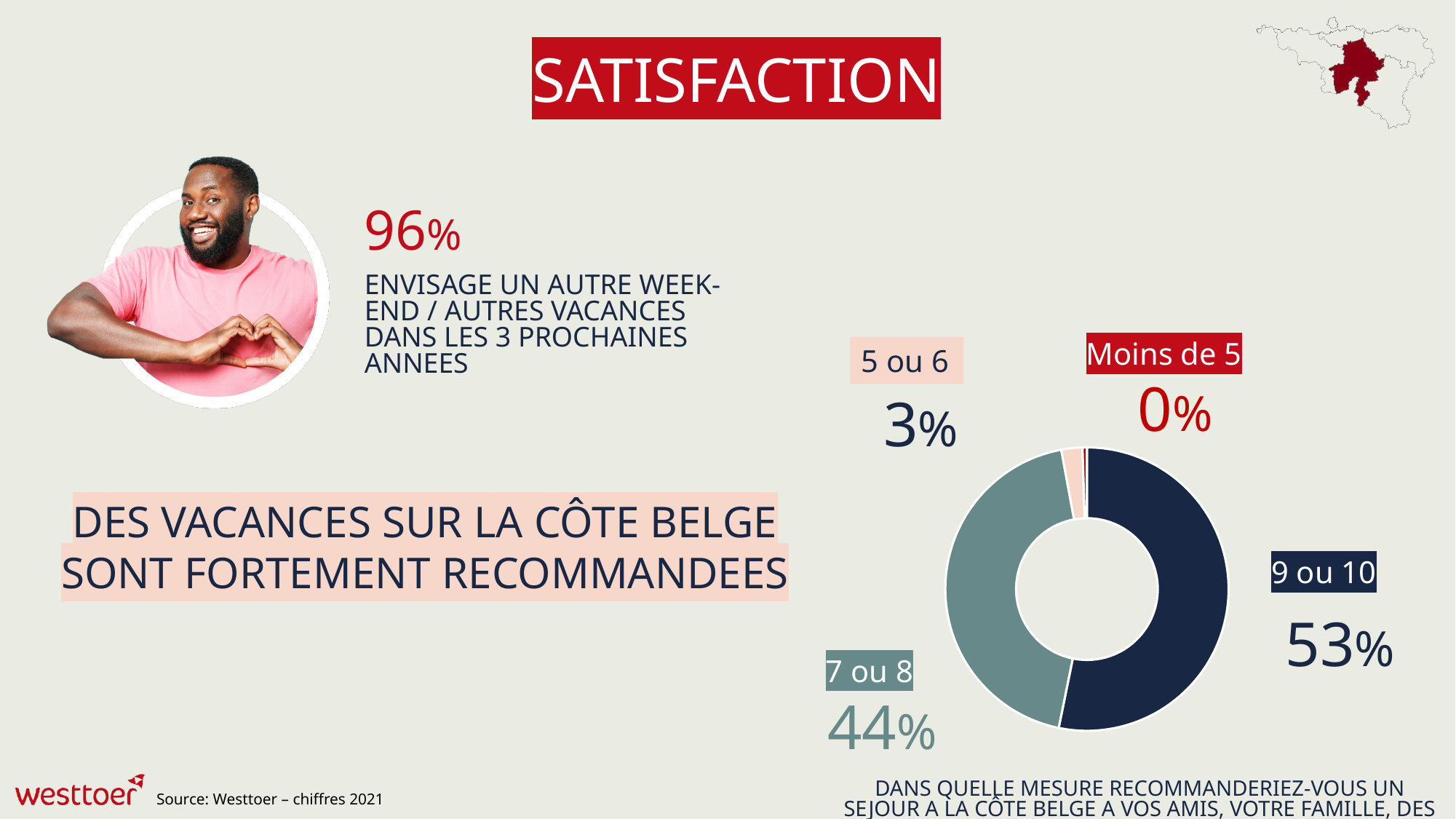
What is the difference in percentage points between the 9 ou 10 and 7 ou 8 shares in the donut chart? 9 What share of respondents gave a score of 7 ou 8 in the donut chart? 44% What is the combined share of the 9 ou 10 and 7 ou 8 categories in the donut chart? 97% What share of respondents gave a score of Moins de 5 in the donut chart? 0% What colour is the 9 ou 10 segment in the donut chart? Dark navy blue What kind of chart is used to show the recommendation scores? Donut chart Which category has the largest share in the donut chart? 9 ou 10 What share of respondents gave a score of 5 ou 6 in the donut chart? 3% Which is larger in the donut chart: the share for 7 ou 8 or the share for 5 ou 6? 7 ou 8 What share of respondents gave a score of 9 ou 10 in the donut chart? 53% How many categories are shown in the donut chart? 4 Which category has the smallest share in the donut chart? Moins de 5